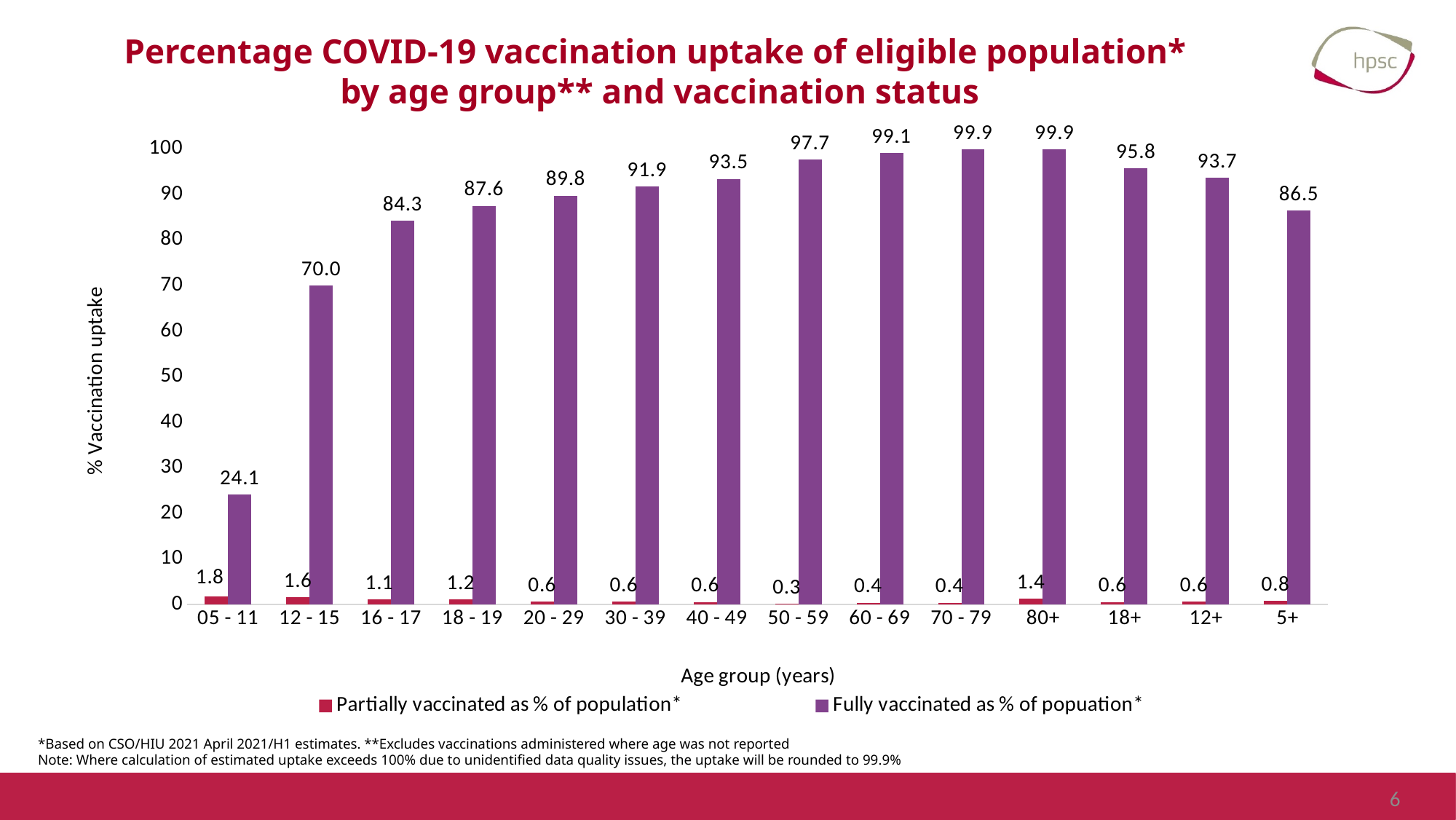
What is the fully vaccinated percentage for the 12 - 15 age group? 70.0 Which has a higher fully vaccinated percentage, the 16 - 17 age group or the 18 - 19 age group? 18 - 19 Which age group has the lowest fully vaccinated percentage? 05 - 11 What is the label of the y axis? % Vaccination uptake How many age groups are shown on the x axis? 14 What is the difference between the fully vaccinated percentages for the 18+ and 12+ age groups? 2.1 Which age group has the lowest partially vaccinated percentage? 50 - 59 Is the fully vaccinated value for the 05 - 11 age group greater or less than 30? less What is the fully vaccinated percentage for the 5+ age group? 86.5 How many series does the legend list? 2 What kind of chart is shown on the slide? bar chart What is the partially vaccinated percentage for the 05 - 11 age group? 1.8